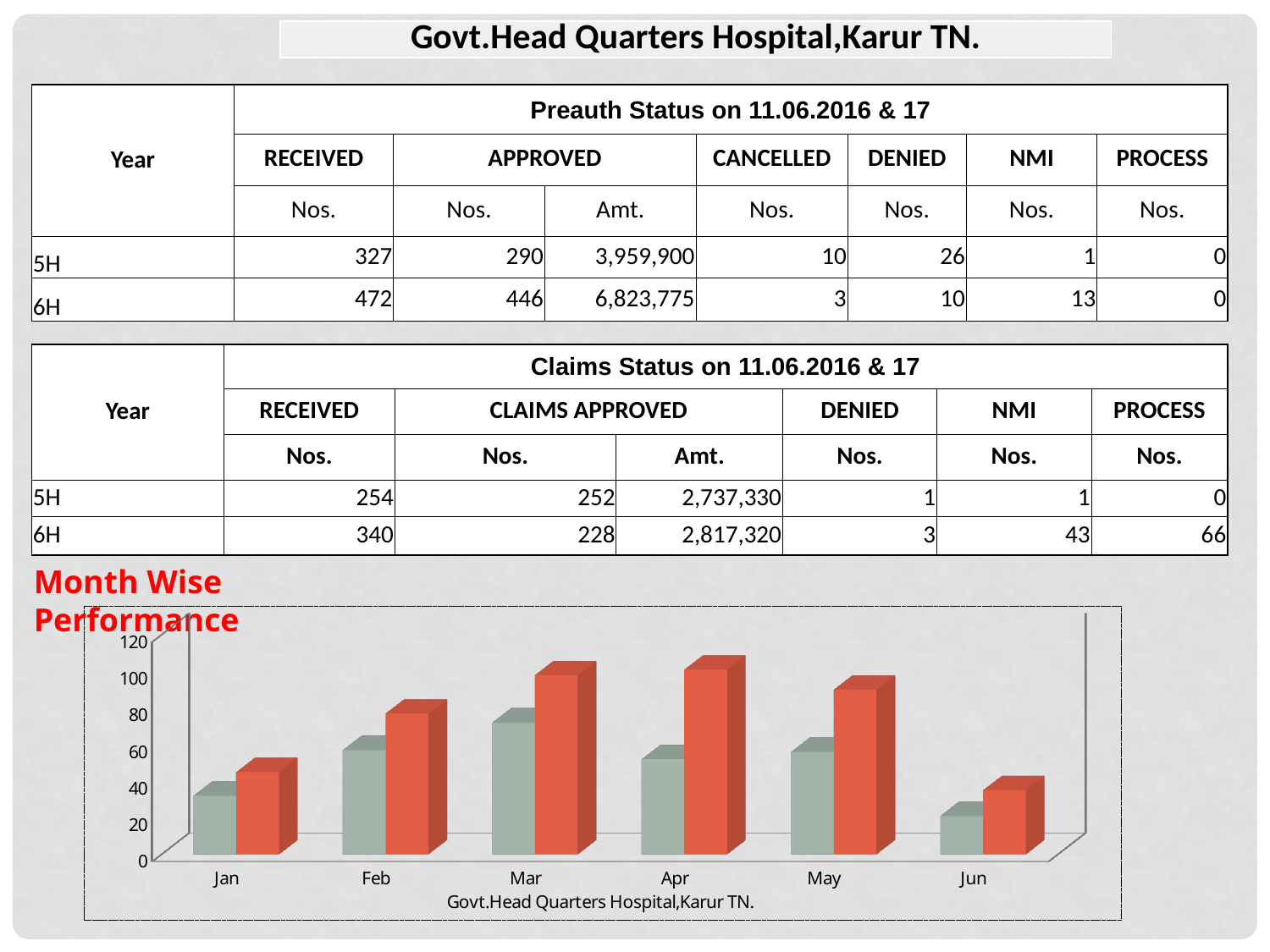
How many months are shown on the x axis of the Month Wise Performance chart? 6 In the Month Wise Performance chart, is the red bar for Jan greater or less than 60? less In the Month Wise Performance chart, which month has the lowest red bar? Jun What text appears as the axis title below the months in the Month Wise Performance chart? Govt.Head Quarters Hospital,Karur TN. In the Month Wise Performance chart, which month has the lowest grey bar? Jun In the Month Wise Performance chart, is the grey bar for Jun greater or less than 40? less What kind of chart is shown under the heading "Month Wise Performance"? bar chart In the Month Wise Performance chart, which month has the highest grey bar? Mar In the Month Wise Performance chart, which is larger: the red bar for Feb or the red bar for Jun? Feb In the Month Wise Performance chart, does the red bar rise or fall from May to Jun? fall In the Month Wise Performance chart, is the red bar for Mar greater or less than 80? greater How many bars are plotted for each month in the Month Wise Performance chart? 2